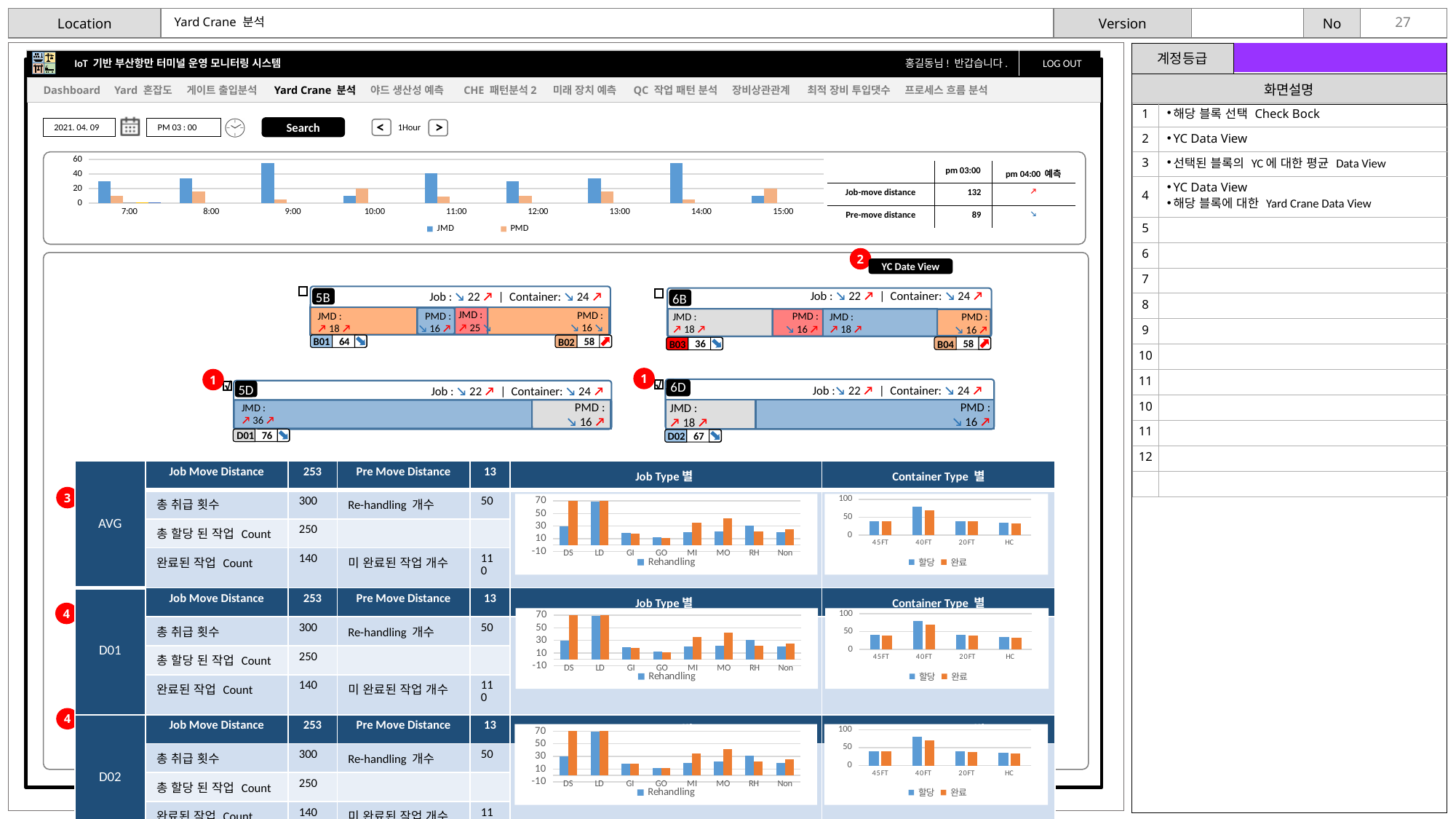
In the top JMD/PMD chart, how many series does the legend list? 2 In the Container Type 별 chart in the AVG row, how many series does the legend list? 2 In the top JMD/PMD chart, which is larger at 15:00, JMD or PMD? PMD In the Job Type 별 chart in the AVG row, which category has the lowest values? GO In the top JMD/PMD chart, which is larger at 7:00, JMD or PMD? JMD In the Job Type 별 chart in the AVG row, is the value for LD greater or less than 50? greater In the Job Type 별 chart in the AVG row, how many categories are on the x axis? 8 In the top JMD/PMD chart, how many time categories are shown on the x axis? 9 In the top JMD/PMD chart, is the JMD value at 9:00 greater or less than 40? greater In the top JMD/PMD chart, is the JMD value at 10:00 greater or less than 20? less In the Container Type 별 chart in the AVG row, which category has the highest values? 40FT What kind of chart is the chart at the top of the slide showing JMD and PMD by hour? bar chart